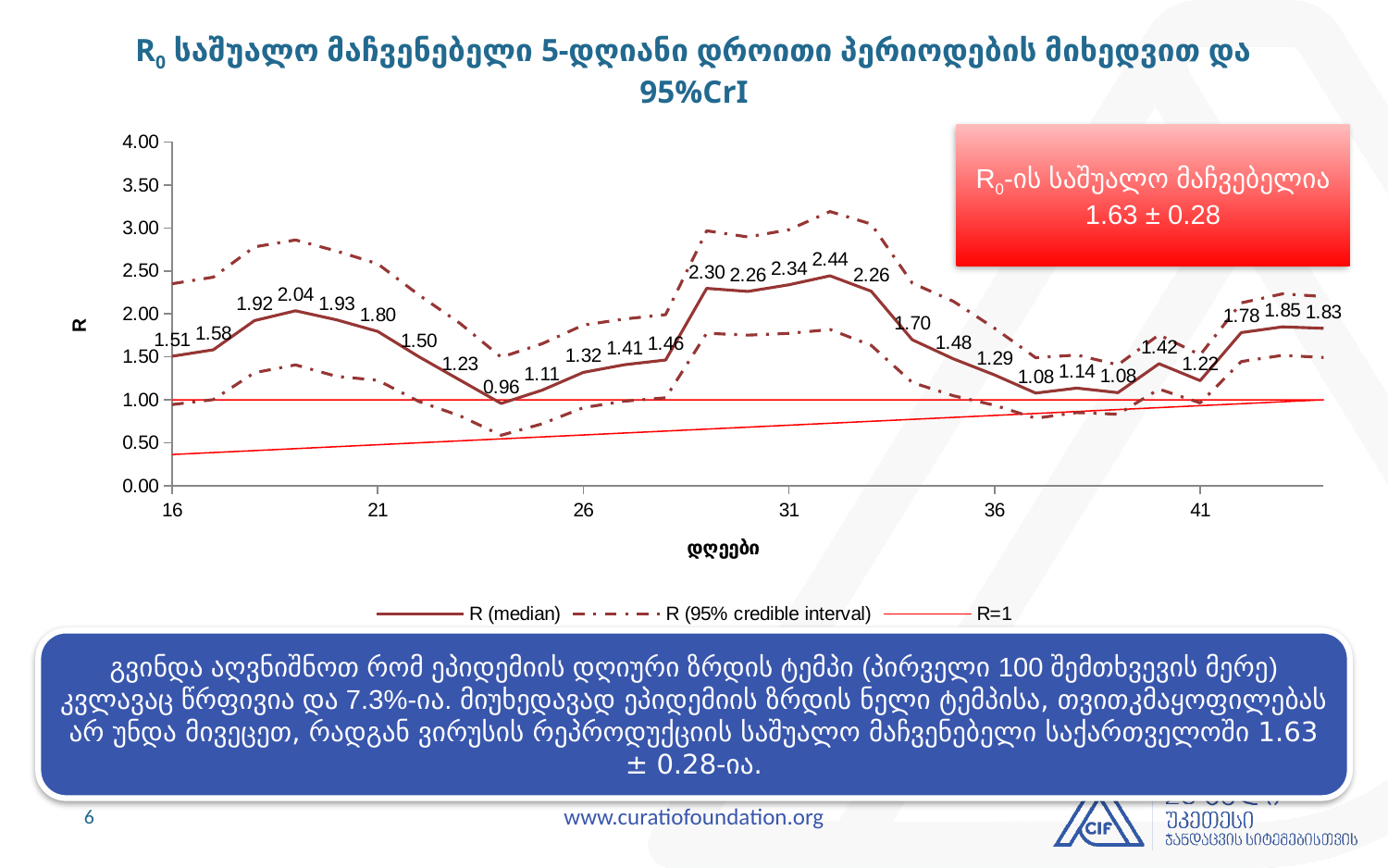
What is the difference between the highest R (median) value (2.44) and the lowest (0.96)? 1.48 Is the upper R (95% credible interval) line at day 32 greater or less than 3.00? greater Which is larger, the R (median) value at day 21 or at day 26? Day 21 (1.80) What is the R (median) value at day 31? 2.34 What is the R (median) value at day 21? 1.80 What kind of chart is shown on the slide? Line chart How many series does the legend list? 3 What is the lowest R (median) value shown on the chart? 0.96 What is the highest R (median) value shown on the chart? 2.44 Does the R (median) line rise or fall between day 36 and day 37? Fall What is the label of the x axis? დღეები What is the R (median) value at day 41? 1.22